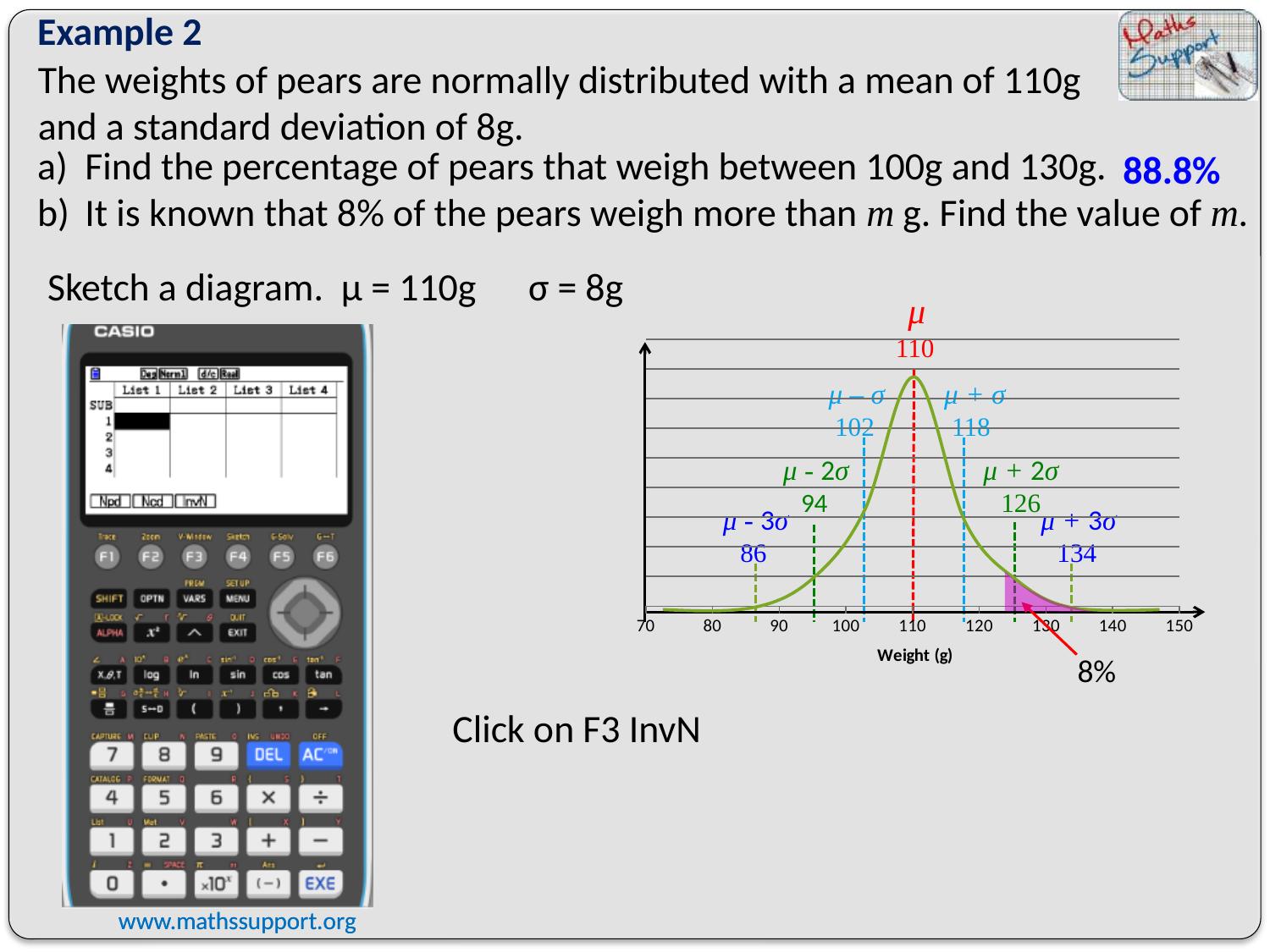
Is the value labelled at μ + 2σ greater or less than 120? greater What value is labelled at μ + 2σ on the curve? 126 What is the difference between the values labelled at μ + σ and μ − σ? 16 What percentage is written next to the shaded region in the right tail of the curve? 8% What value is labelled at the mean (μ) on the normal distribution curve? 110 What is the title of the horizontal axis of the curve? Weight (g) What value is labelled at μ + σ on the curve? 118 What is the highest value shown on the horizontal axis of the curve? 150 What value is labelled at μ + 3σ on the curve? 134 What value is labelled at μ − σ on the curve? 102 What value is labelled at μ − 3σ on the curve? 86 What is the difference between the values labelled at μ + 3σ and μ − 3σ? 48